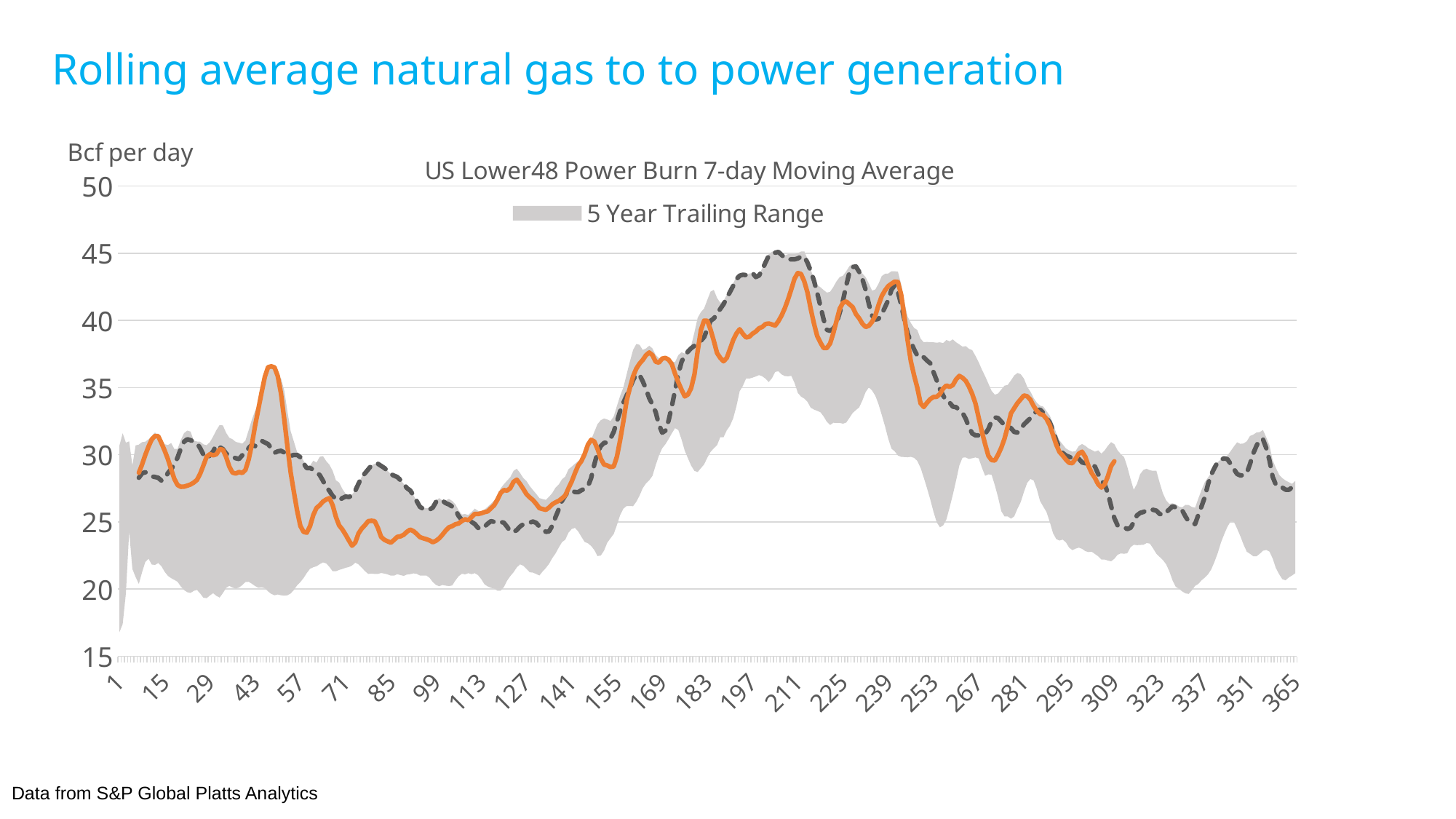
What series does the chart legend list for the grey shaded area? 5 Year Trailing Range How many tick labels are printed along the x axis? 27 Is the value of the dashed line at day 323 greater or less than 30? less At the orange line's peak near day 50, is the orange line above or below the dashed line? above Is the value of the dashed line at day 351 greater or less than 25? greater Is the value of the orange line at day 211 greater or less than 40? greater Between day 239 and day 309, does the orange line generally rise or fall? fall Between day 141 and day 211, does the orange line generally rise or fall? rise What kind of chart is shown on the slide? combination area and line chart What is the title printed above the chart? US Lower48 Power Burn 7-day Moving Average